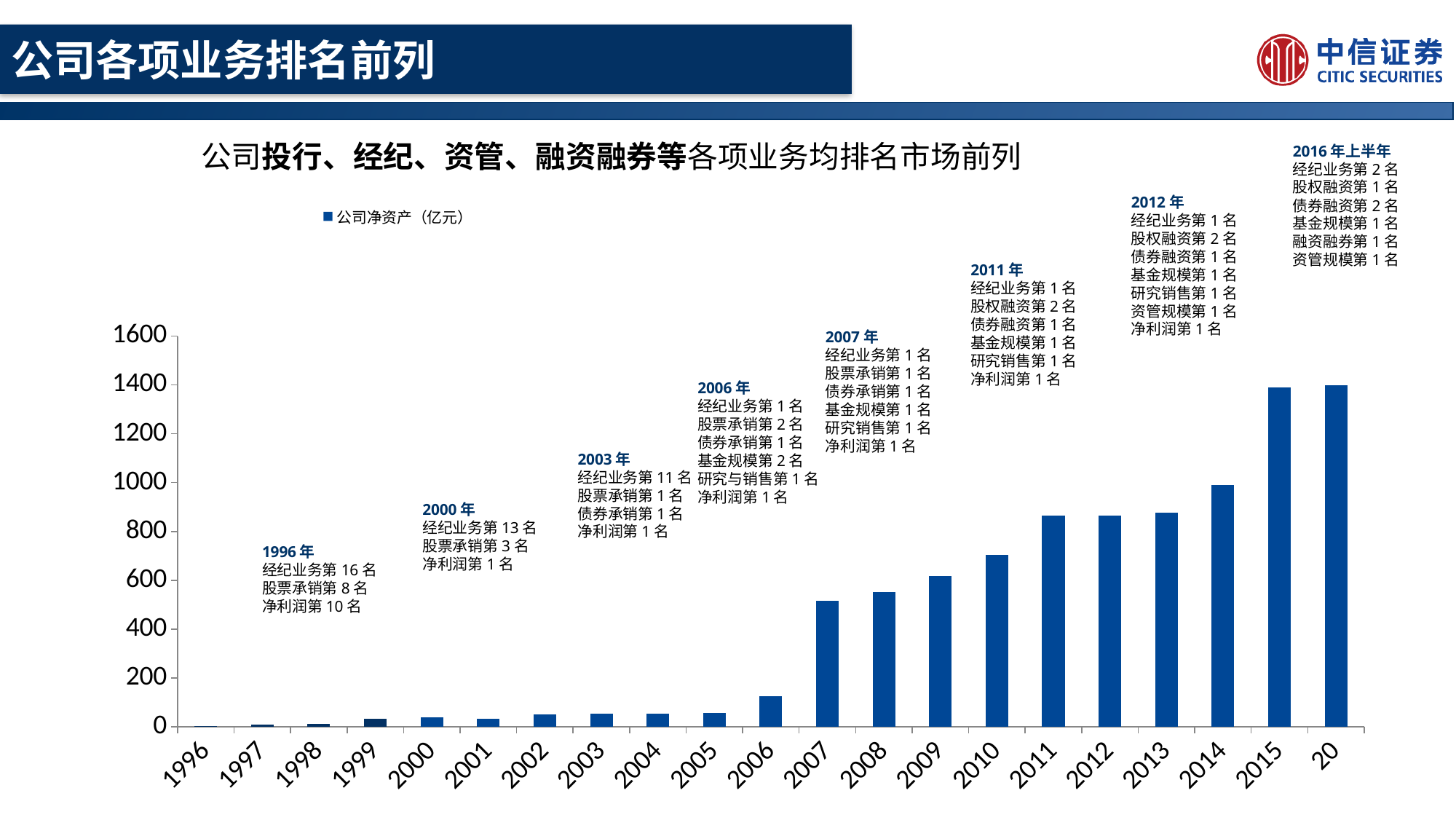
How many years (categories) are plotted along the x axis? 21 What kind of chart is shown on the slide? bar chart Do the 公司净资产 values generally rise or fall from 1996 to the last year shown? rise What is the series name shown in the chart legend? 公司净资产（亿元） Is the value for 2006 greater or less than 200? less How many series does the chart legend list? 1 Which year has the lowest 公司净资产 value? 1996 Which is larger, the value for 2006 or the value for 2007? 2007 Is the value for 2007 greater or less than 400? greater Which is larger, the value for 2013 or the value for 2014? 2014 Is the value for 2015 greater or less than 1200? greater